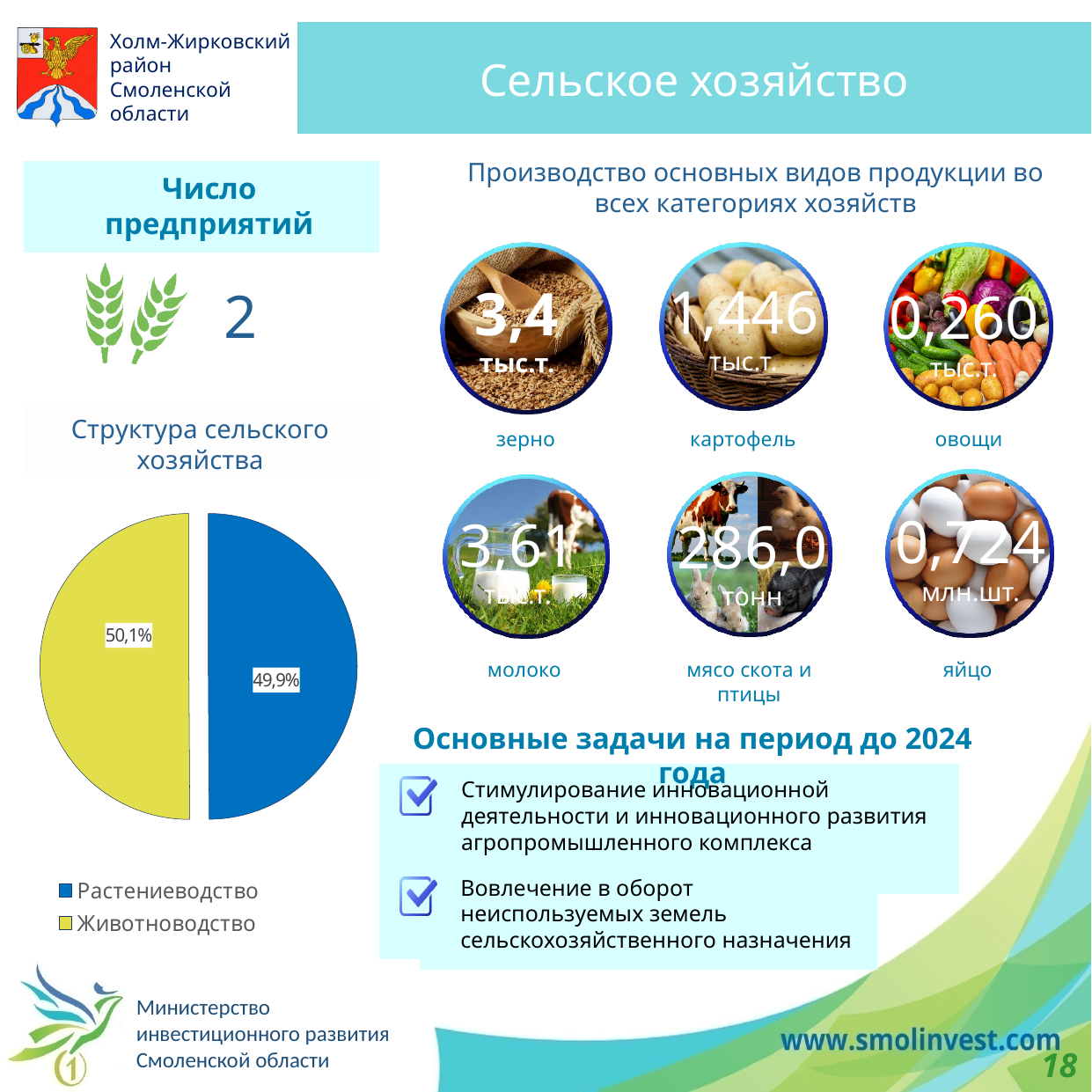
In the pie chart "Структура сельского хозяйства", which colour represents Растениеводство? blue What kind of chart is shown under the heading "Структура сельского хозяйства"? pie chart In the pie chart "Структура сельского хозяйства", what is the difference in percentage points between the Животноводство and Растениеводство shares? 0,2 According to the data labels in the pie chart "Структура сельского хозяйства", which category has the larger share? Животноводство In the pie chart "Структура сельского хозяйства", what share is shown for Растениеводство? 49,9% In the pie chart "Структура сельского хозяйства", which colour represents Животноводство? yellow How many slices does the pie chart "Структура сельского хозяйства" have? 2 In the pie chart "Структура сельского хозяйства", what is the total of the two slice shares? 100% In the pie chart "Структура сельского хозяйства", what share is shown for Животноводство? 50,1% In the pie chart "Структура сельского хозяйства", is the share for Растениеводство greater or less than 50%? less How many entries does the legend of the pie chart "Структура сельского хозяйства" list? 2 According to the data labels in the pie chart "Структура сельского хозяйства", which category has the smaller share? Растениеводство